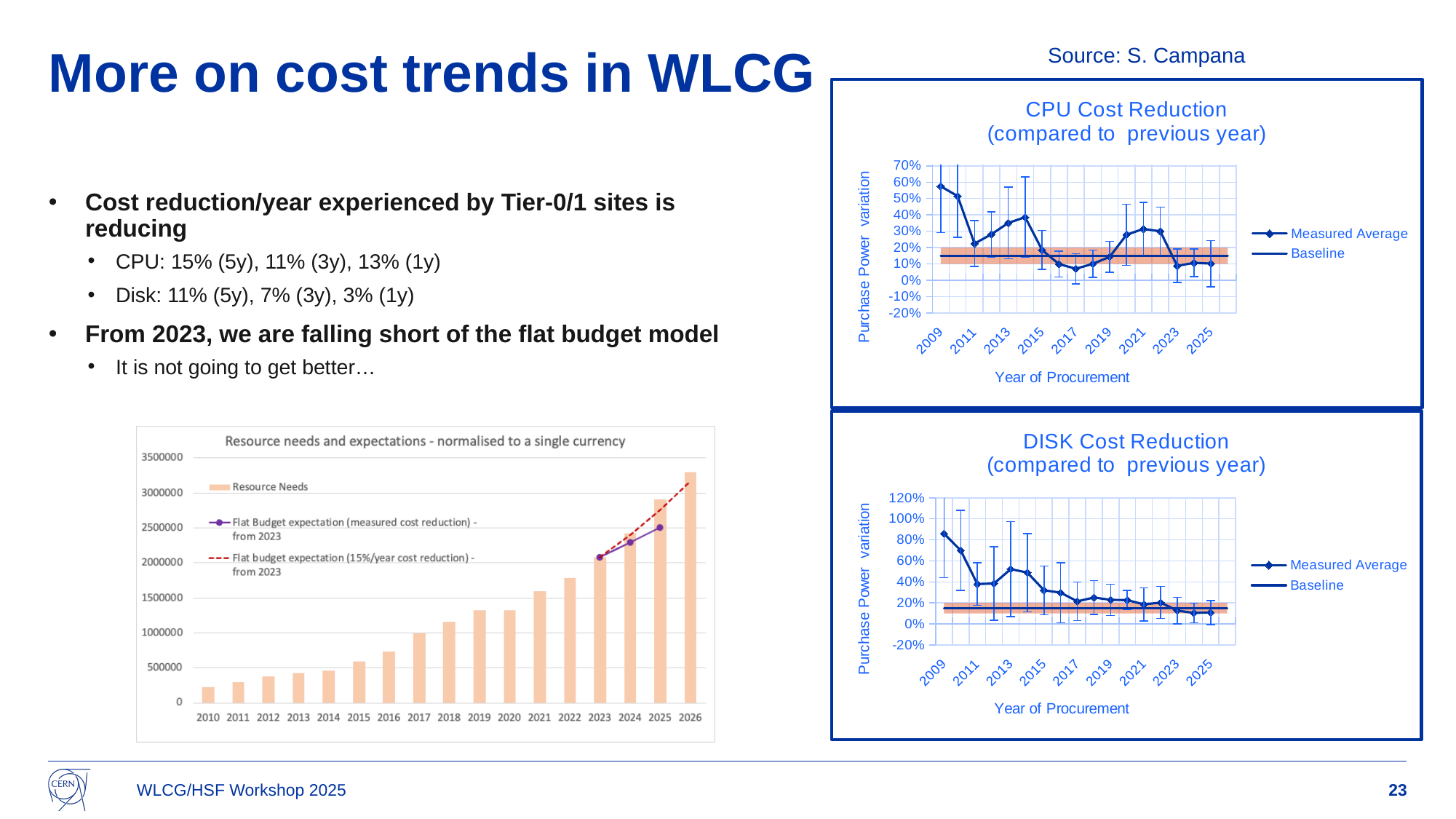
How many bars (years) are shown in the 'Resource needs and expectations' chart? 17 In the 'CPU Cost Reduction' chart, which is larger, the Measured Average for 2015 or for 2017? 2015 How many series does the legend of the 'DISK Cost Reduction' chart list? 2 In the 'DISK Cost Reduction' chart, is the Measured Average value for 2009 greater or less than 80%? greater In the 'CPU Cost Reduction' chart, is the Measured Average value for 2017 greater or less than 10%? less In the 'Resource needs and expectations' chart, do the Resource Needs bars rise or fall from 2010 to 2026? rise In the 'Resource needs and expectations' chart, is the Resource Needs value for 2026 greater or less than 3000000? greater In the 'CPU Cost Reduction' chart, which year has the highest Measured Average value? 2009 What is the x-axis title of the 'DISK Cost Reduction' chart? Year of Procurement What kind of chart is the 'Resource needs and expectations - normalised to a single currency' chart mainly made of? bar chart How many entries does the legend of the 'Resource needs and expectations' chart list? 3